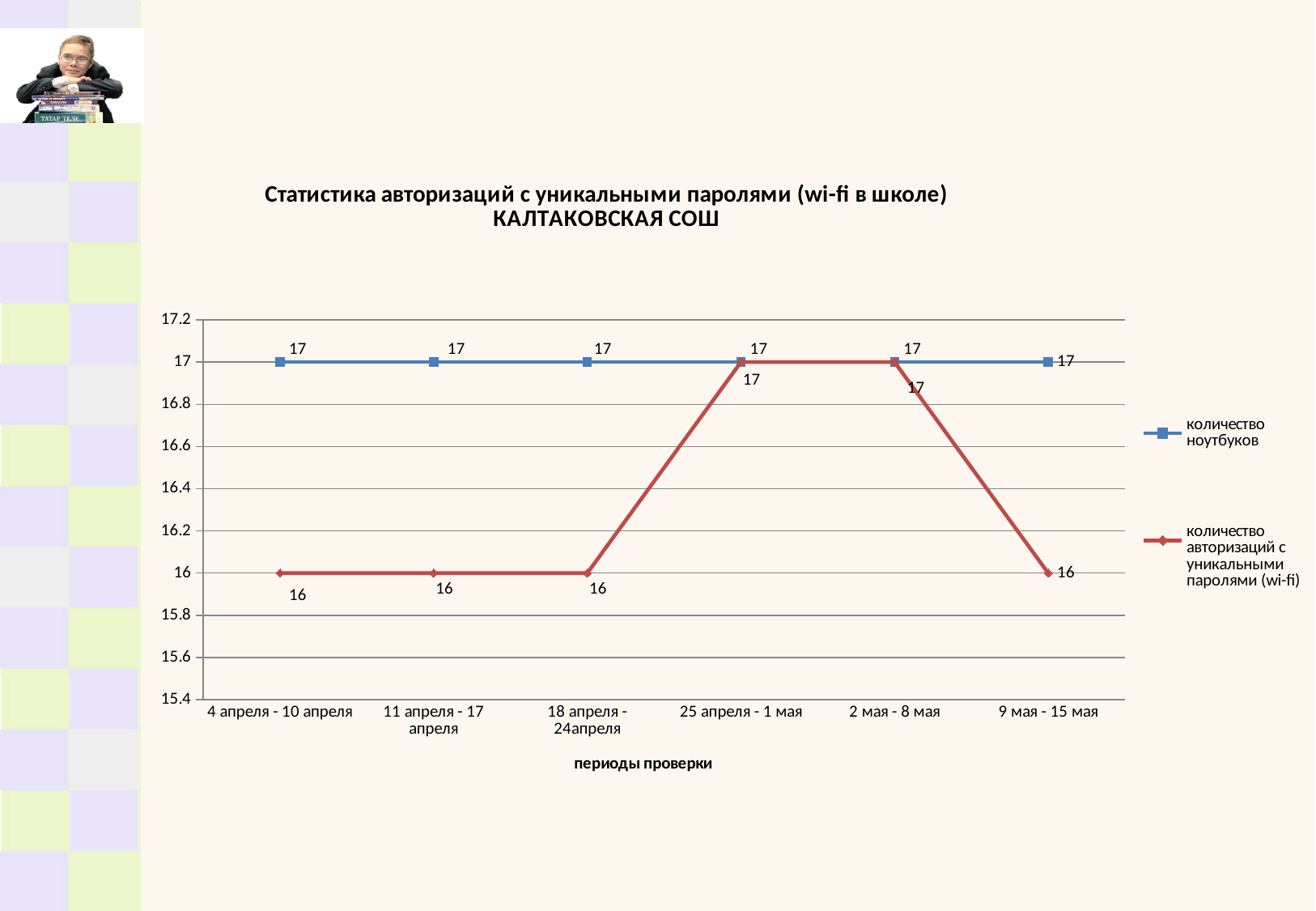
What kind of chart is shown on the slide? line chart Which is larger for the period '4 апреля - 10 апреля': 'количество ноутбуков' or 'количество авторизаций с уникальными паролями (wi-fi)'? количество ноутбуков What is the label of the x axis? периоды проверки How many series does the legend list? 2 What is the value of 'количество авторизаций с уникальными паролями (wi-fi)' for the period '9 мая - 15 мая'? 16 Does the 'количество авторизаций с уникальными паролями (wi-fi)' series rise or fall between '2 мая - 8 мая' and '9 мая - 15 мая'? fall What is the value of 'количество авторизаций с уникальными паролями (wi-fi)' for the period '18 апреля - 24апреля'? 16 What is the value of 'количество ноутбуков' for the period '4 апреля - 10 апреля'? 17 What is the value of 'количество авторизаций с уникальными паролями (wi-fi)' for the period '25 апреля - 1 мая'? 17 How many periods are shown on the x axis? 6 What is the difference between 'количество ноутбуков' and 'количество авторизаций с уникальными паролями (wi-fi)' for the period '11 апреля - 17 апреля'? 1 What is the title of the chart? Статистика авторизаций с уникальными паролями (wi-fi в школе) КАЛТАКОВСКАЯ СОШ